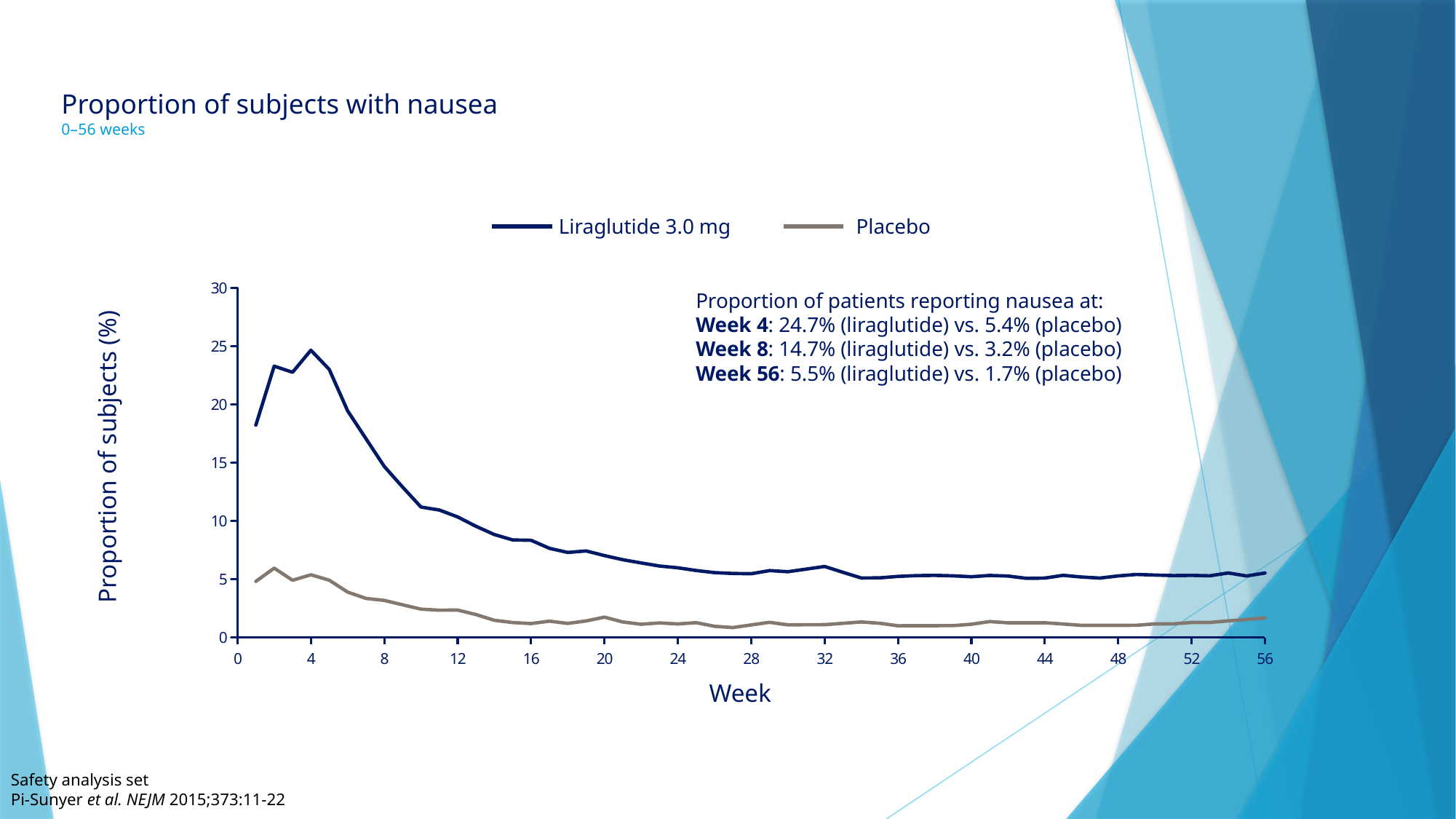
What is the label of the x axis? Week What kind of chart is shown on the slide? line chart What proportion of placebo subjects reported nausea at week 4? 5.4% Which series has the higher proportion of subjects with nausea at week 8? Liraglutide 3.0 mg Is the value for liraglutide 3.0 mg at week 16 greater or less than 10? less What proportion of placebo subjects reported nausea at week 56? 1.7% How many series does the legend list? 2 What proportion of liraglutide 3.0 mg subjects reported nausea at week 8? 14.7% Does the liraglutide 3.0 mg line rise or fall between week 4 and week 12? fall What is the difference between the liraglutide 3.0 mg and placebo proportions at week 4? 19.3% What proportion of liraglutide 3.0 mg subjects reported nausea at week 4? 24.7% What is the difference between the liraglutide 3.0 mg and placebo proportions at week 56? 3.8%